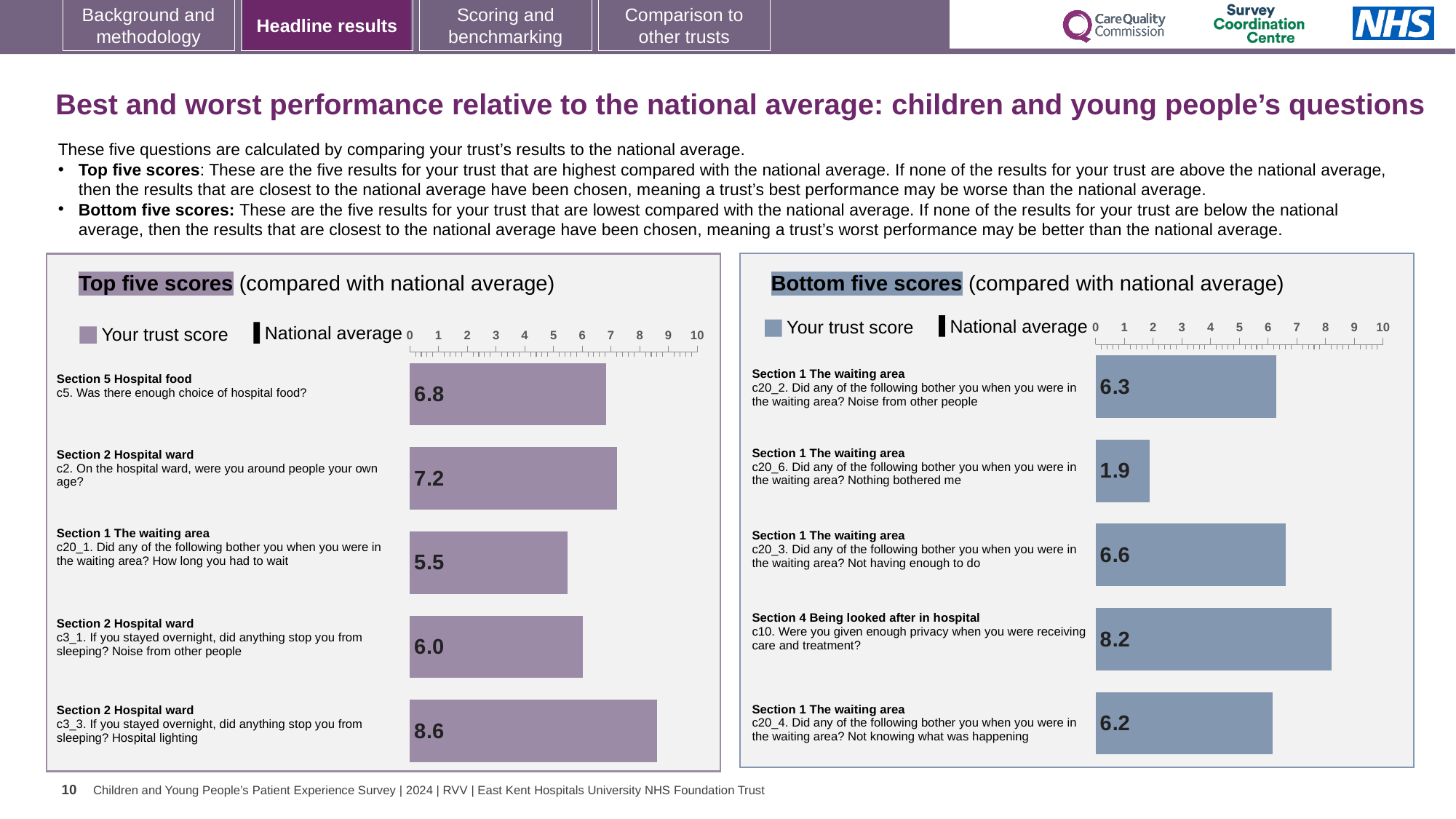
How many entries does the legend of the Bottom five scores chart list? 2 In the Top five scores chart, what is the trust score for c5 (Was there enough choice of hospital food?)? 6.8 In the Bottom five scores chart, what is the difference between the scores for c10 and c20_2? 1.9 In the Top five scores chart, what is the difference between the scores for c2 and c3_1? 1.2 In the Top five scores chart, how many questions are plotted? 5 In the Top five scores chart, what is the trust score for c3_3 (Hospital lighting)? 8.6 In the Top five scores chart, which question has the lowest trust score? c20_1. How long you had to wait In the Bottom five scores chart, is the score for c20_6 greater or less than 2? less In the Bottom five scores chart, which question has the highest trust score? c10. Were you given enough privacy when you were receiving care and treatment? In the Bottom five scores chart, which is larger: the score for c20_3 or the score for c20_4? c20_3 In the Bottom five scores chart, what is the trust score for c20_6 (Nothing bothered me)? 1.9 What kind of chart is the Top five scores chart? Bar chart